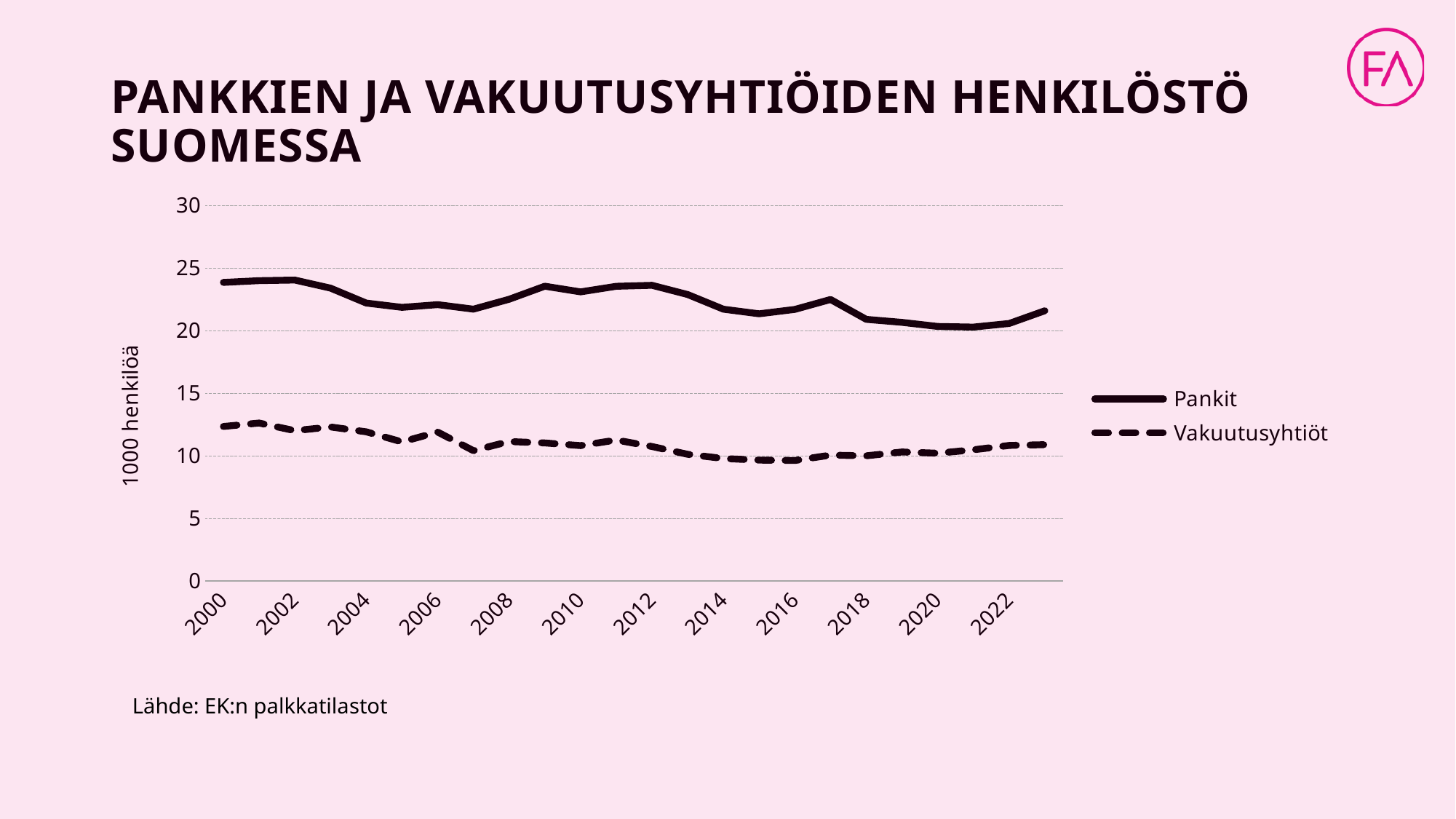
Is the value for Pankit in 2000 greater or less than 20? greater What are the two series named in the legend? Pankit and Vakuutusyhtiöt Is the value for Vakuutusyhtiöt in 2002 greater or less than 10? greater How many year labels are shown on the x axis? 12 Is the value for Vakuutusyhtiöt in 2012 greater or less than 15? less Does the Vakuutusyhtiöt line overall rise or fall from 2000 to 2016? Fall What kind of chart is shown on the slide? Line chart What is the label on the vertical axis? 1000 henkilöä Which series has the higher value in 2010, Pankit or Vakuutusyhtiöt? Pankit Does the Pankit line overall rise or fall from 2000 to 2022? Fall How many series does the legend list? 2